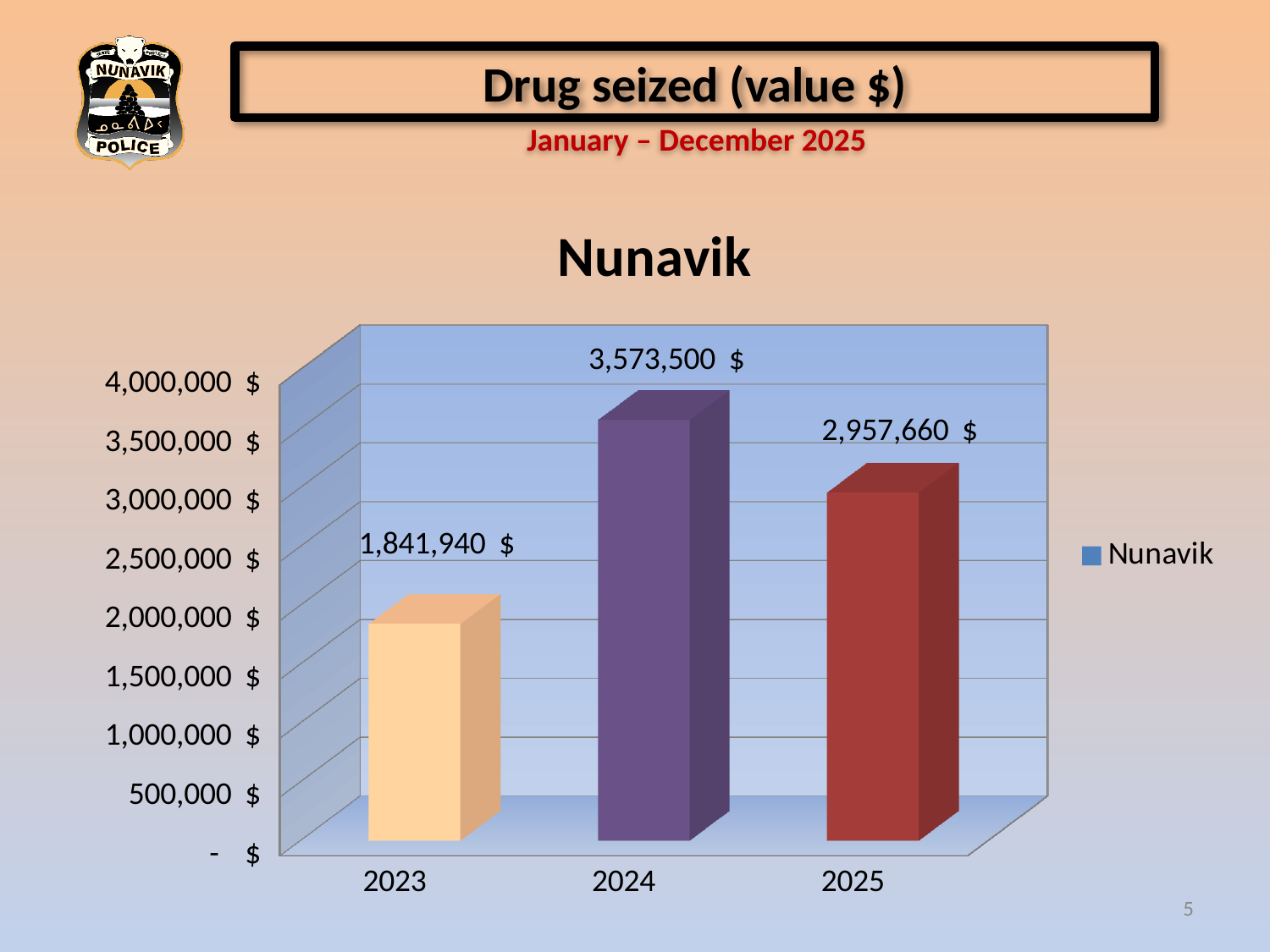
What is the value of drugs seized in 2024? 3,573,500 $ What is the value of drugs seized in 2025? 2,957,660 $ Which year had a larger value of drugs seized, 2023 or 2025? 2025 How many series does the legend list? 1 Which year has the highest value of drugs seized? 2024 What kind of chart is shown on the slide? Bar chart What is the value of drugs seized in 2023? 1,841,940 $ Which year has the lowest value of drugs seized? 2023 What is the title of the chart? Nunavik How many years are shown on the chart? 3 What is the difference between the value of drugs seized in 2024 and in 2025? 615,840 $ What is the difference between the value of drugs seized in 2025 and in 2023? 1,115,720 $